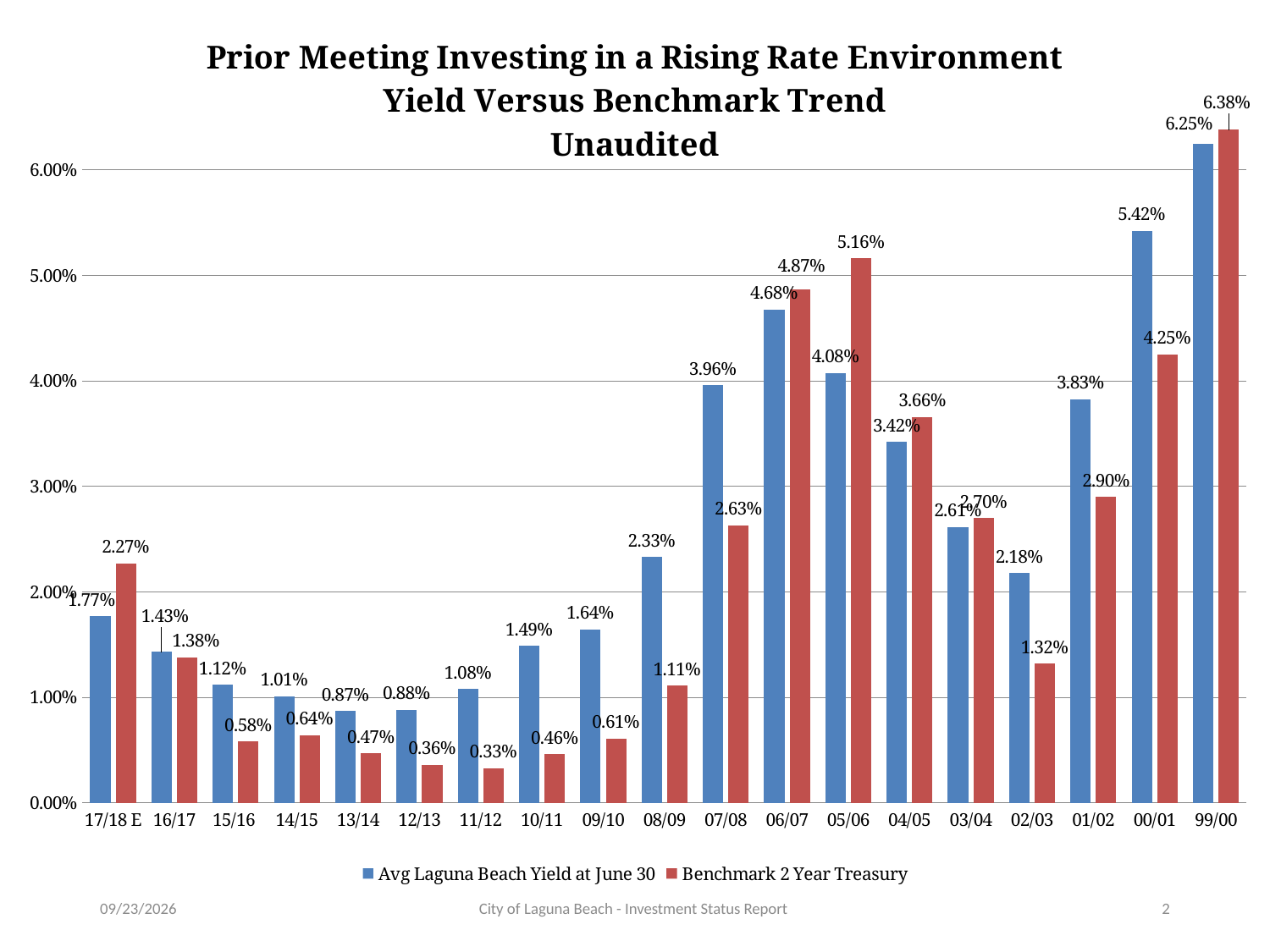
Which fiscal year has the lowest Benchmark 2 Year Treasury value? 11/12 What kind of chart is shown on the slide? Bar chart Which colour represents the Benchmark 2 Year Treasury series? Red How many series does the legend list? 2 What is the Avg Laguna Beach Yield at June 30 for 07/08? 3.96% For 00/01, which is larger: the Avg Laguna Beach Yield at June 30 or the Benchmark 2 Year Treasury? Avg Laguna Beach Yield at June 30 What is the Benchmark 2 Year Treasury value for 11/12? 0.33% What is the Benchmark 2 Year Treasury value for 05/06? 5.16% Is the Avg Laguna Beach Yield at June 30 for 01/02 greater or less than 4.00%? less How many fiscal years are shown on the x axis? 19 Which fiscal year has the highest Avg Laguna Beach Yield at June 30? 99/00 What is the difference between the Benchmark 2 Year Treasury and the Avg Laguna Beach Yield at June 30 for 17/18 E? 0.50%